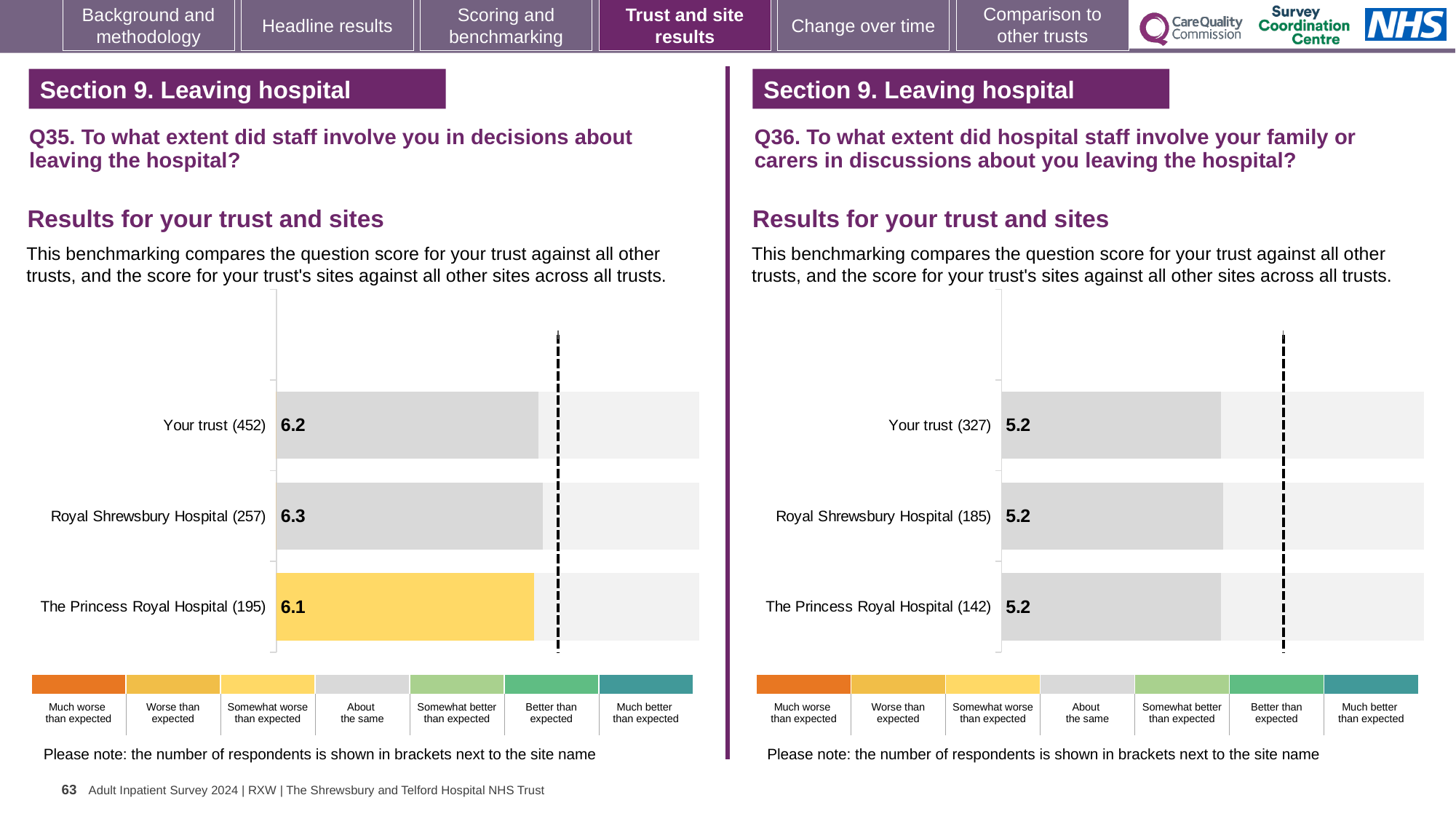
In the Q35 chart on the left, which site or trust has the highest score? Royal Shrewsbury Hospital In the Q35 chart on the left, what is the score for Royal Shrewsbury Hospital? 6.3 In the Q35 chart on the left, which bar is coloured yellow rather than grey? The Princess Royal Hospital In the Q35 chart on the left, what is the difference between the scores for Royal Shrewsbury Hospital and The Princess Royal Hospital? 0.2 In the Q35 chart on the left, what is the score for The Princess Royal Hospital? 6.1 In the Q36 chart on the right, what is the score for The Princess Royal Hospital? 5.2 In the Q35 chart on the left, how many bars are plotted? 3 In the Q36 chart on the right, how many respondents are shown in brackets for Royal Shrewsbury Hospital? 185 In the Q35 chart on the left, what is the score for Your trust? 6.2 In the Q36 chart on the right, what is the score for Your trust? 5.2 In the Q35 chart on the left, which site or trust has the lowest score? The Princess Royal Hospital What kind of chart is the Q35 chart on the left? Bar chart